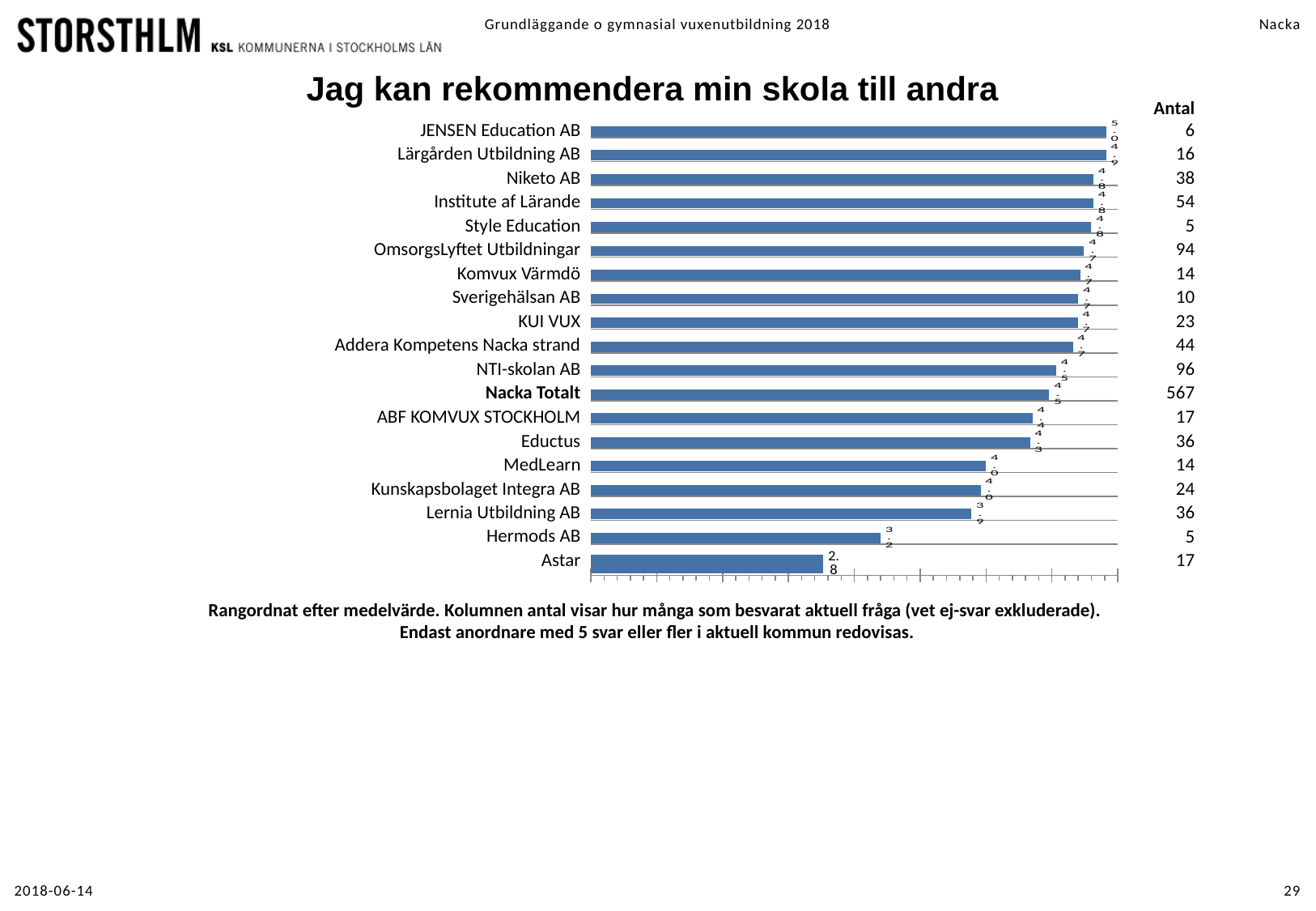
Which category has the lowest value in the chart? Astar What is the value shown for Astar? 2.8 What is the value shown for JENSEN Education AB? 5.0 Do the bar values rise or fall going from the top of the chart to the bottom? fall What kind of chart is shown on the slide? bar chart Which has a larger value, Hermods AB or Lernia Utbildning AB? Lernia Utbildning AB What is the title of the chart? Jag kan rekommendera min skola till andra What is the difference between the values for JENSEN Education AB and Astar? 2.2 What is the Antal (number of respondents) shown for Nacka Totalt? 567 How many schools/categories are listed in the chart? 19 Which category has the highest value in the chart? JENSEN Education AB What is the value shown for Nacka Totalt? 4.5